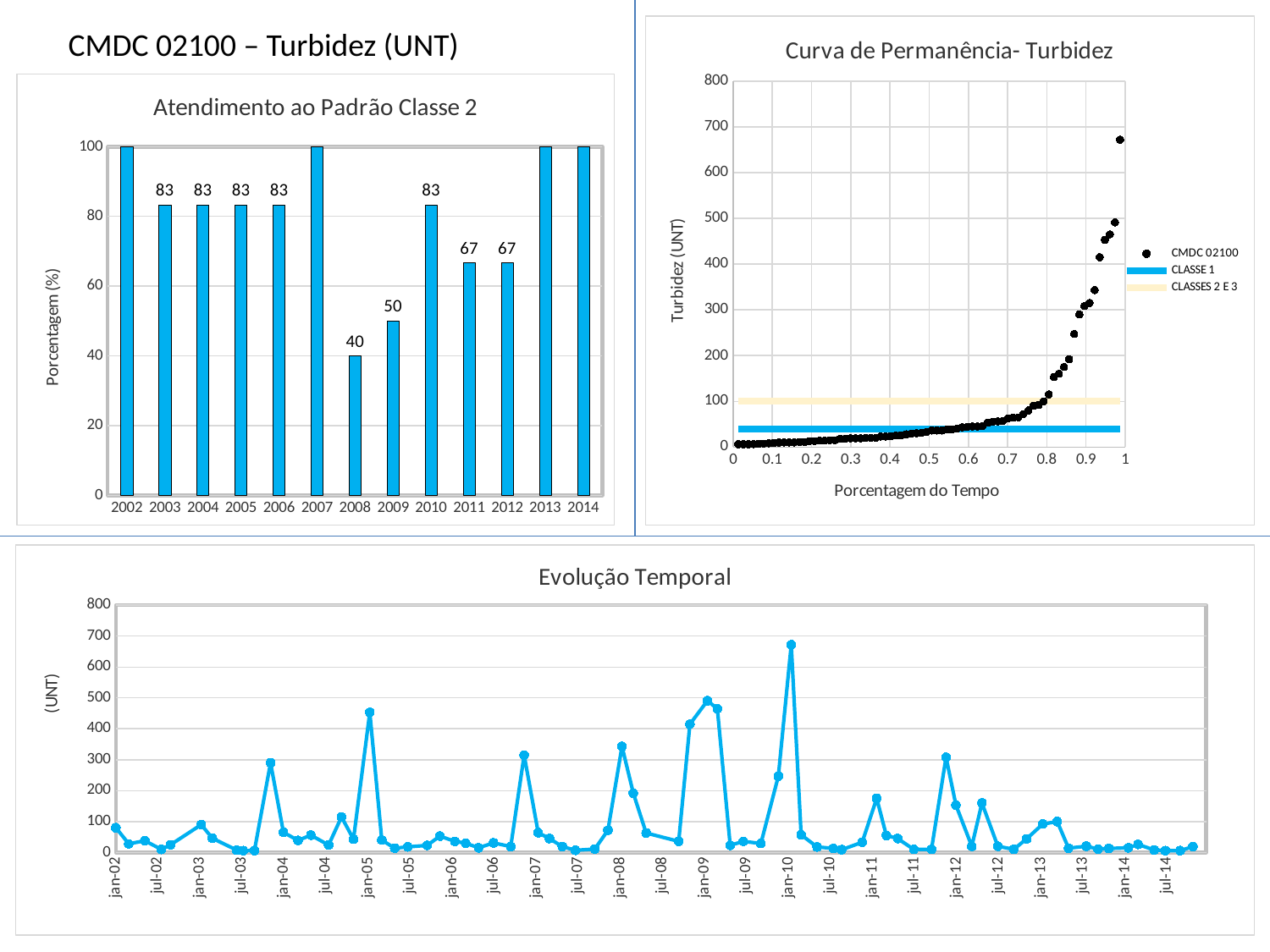
In the 'Atendimento ao Padrão Classe 2' chart, which is larger, the value for 2010 or the value for 2012? 2010 How many years are shown in the 'Atendimento ao Padrão Classe 2' chart? 13 In the 'Evolução Temporal' chart, is the peak value near jan-10 greater or less than 600? greater What kind of chart is 'Atendimento ao Padrão Classe 2'? bar chart In the 'Atendimento ao Padrão Classe 2' chart, what is the difference between the values for 2009 and 2008? 10 How many series does the legend of the 'Curva de Permanência- Turbidez' chart list? 3 In the 'Atendimento ao Padrão Classe 2' chart, what is the value for 2008? 40 In the 'Evolução Temporal' chart, is the peak value near jan-05 greater or less than 400? greater In the 'Atendimento ao Padrão Classe 2' chart, what is the value for 2011? 67 In the 'Atendimento ao Padrão Classe 2' chart, which year has the lowest value? 2008 In the 'Curva de Permanência- Turbidez' chart, do the CMDC 02100 values rise or fall as Porcentagem do Tempo increases? rise What kind of chart is 'Evolução Temporal'? line chart